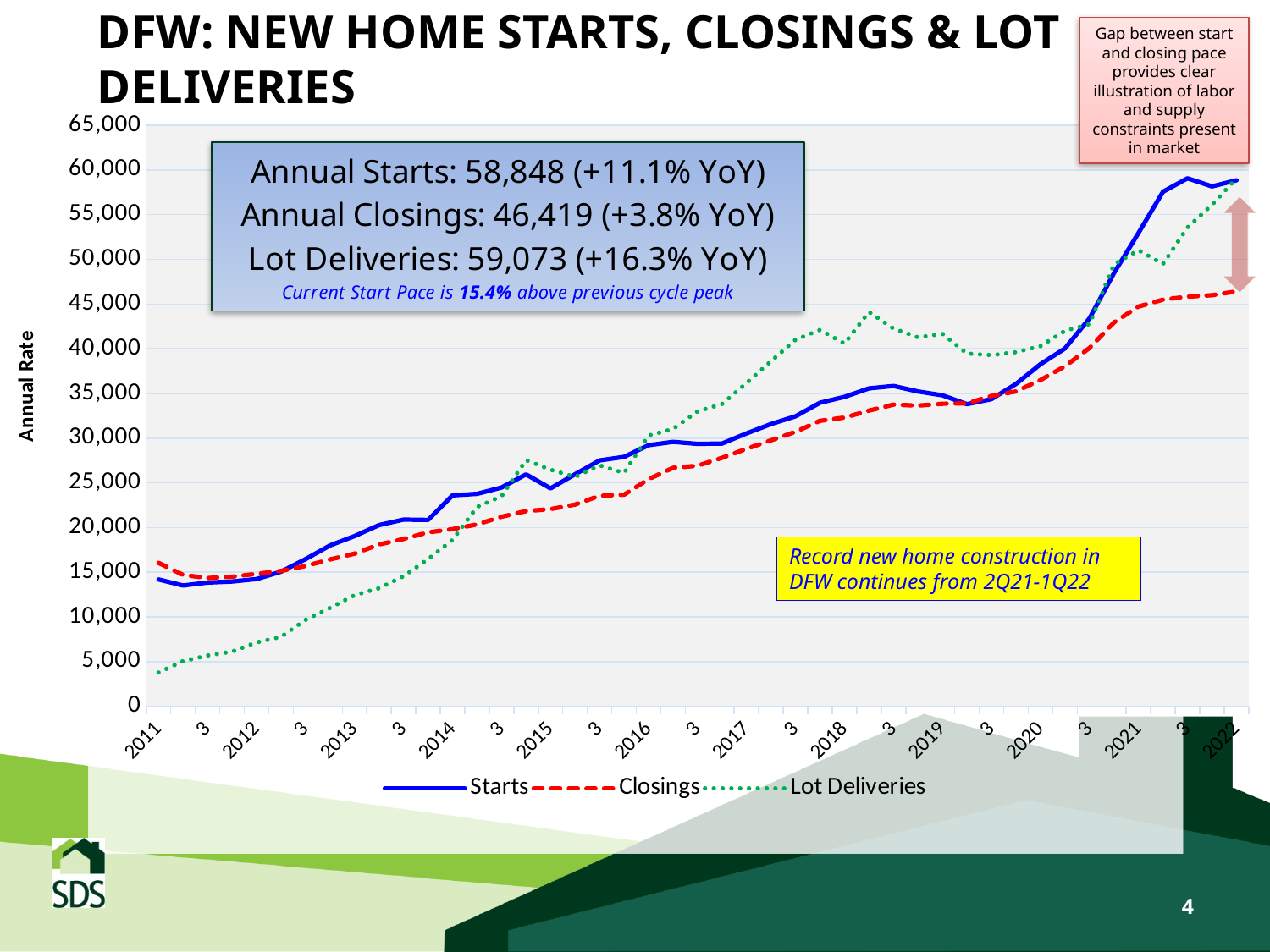
According to the text box on the chart, what is the Annual Closings value? 46,419 At 2018, which series is higher: Lot Deliveries or Starts? Lot Deliveries Is the value for Starts at 2022 greater or less than 55,000? greater According to the text box on the chart, what is the Annual Starts value? 58,848 How many series does the legend list? 3 What are the three series named in the legend? Starts, Closings, Lot Deliveries Do the Starts values generally rise or fall from 2011 to 2022? rise Is the value for Lot Deliveries at the start of 2011 greater or less than 5,000? less What kind of chart is shown on the slide? line chart At 2022, which series is higher: Starts or Closings? Starts Using the values in the text box, what is the difference between Annual Starts and Annual Closings? 12,429 According to the text box on the chart, what is the Lot Deliveries value? 59,073